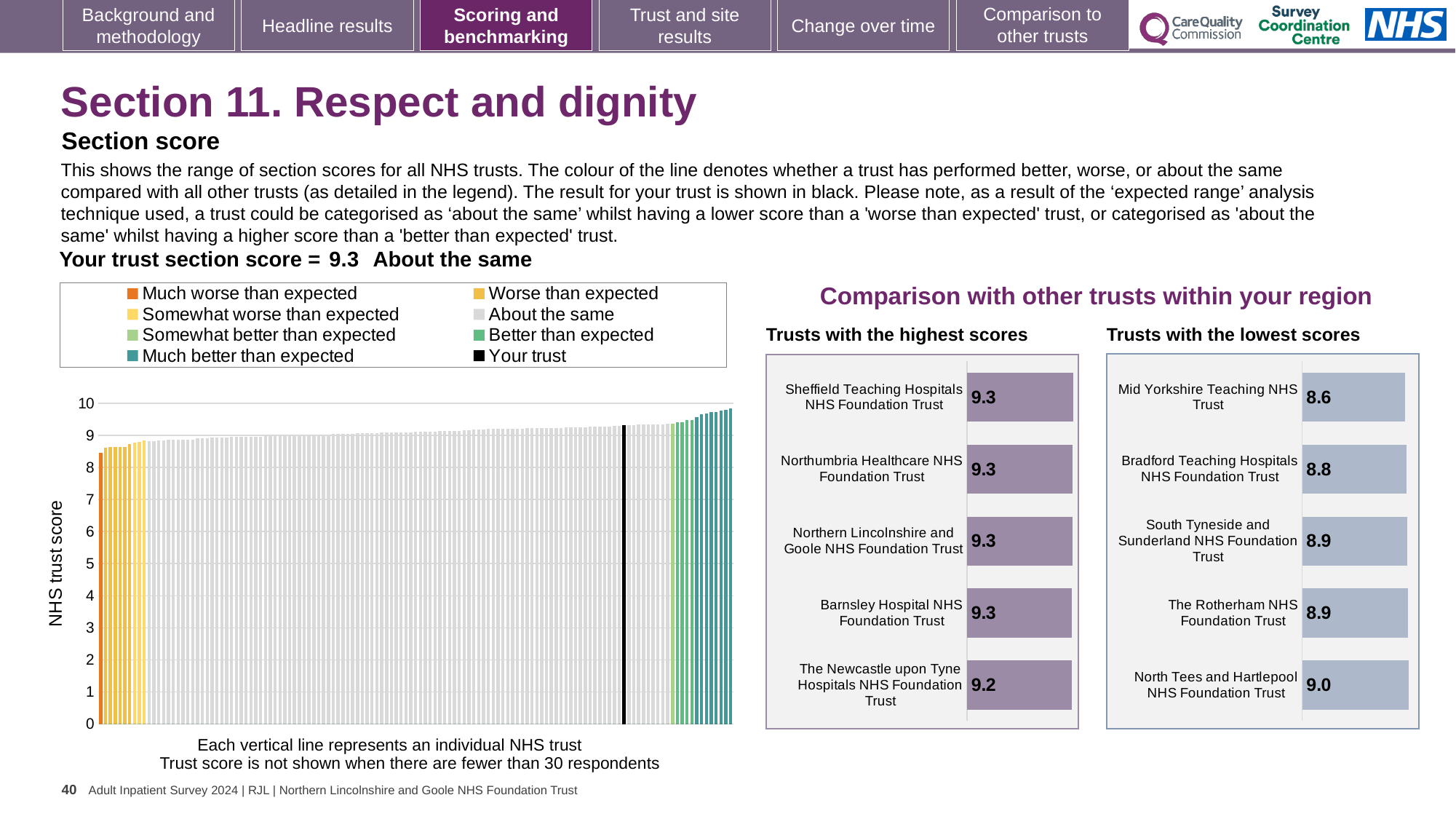
What kind of chart is the NHS trust score chart on the left of the slide? Bar chart In the 'Trusts with the lowest scores' chart, what is the difference between the scores of North Tees and Hartlepool NHS Foundation Trust and Mid Yorkshire Teaching NHS Trust? 0.4 How many trusts are listed in the 'Trusts with the highest scores' chart? 5 In the NHS trust score chart on the left, do the values rise or fall from left to right? Rise In the 'Trusts with the highest scores' chart, which trust has the lowest score? The Newcastle upon Tyne Hospitals NHS Foundation Trust How many entries does the legend of the NHS trust score chart on the left list? 8 In the 'Trusts with the lowest scores' chart, what is the score for North Tees and Hartlepool NHS Foundation Trust? 9.0 In the NHS trust score chart on the left, what colour is used for 'Your trust'? Black In the 'Trusts with the lowest scores' chart, which has the higher score: Bradford Teaching Hospitals NHS Foundation Trust or South Tyneside and Sunderland NHS Foundation Trust? South Tyneside and Sunderland NHS Foundation Trust In the 'Trusts with the lowest scores' chart, which trust has the lowest score? Mid Yorkshire Teaching NHS Trust In the 'Trusts with the highest scores' chart, what is the score for The Newcastle upon Tyne Hospitals NHS Foundation Trust? 9.2 In the 'Trusts with the lowest scores' chart, what is the score for Mid Yorkshire Teaching NHS Trust? 8.6